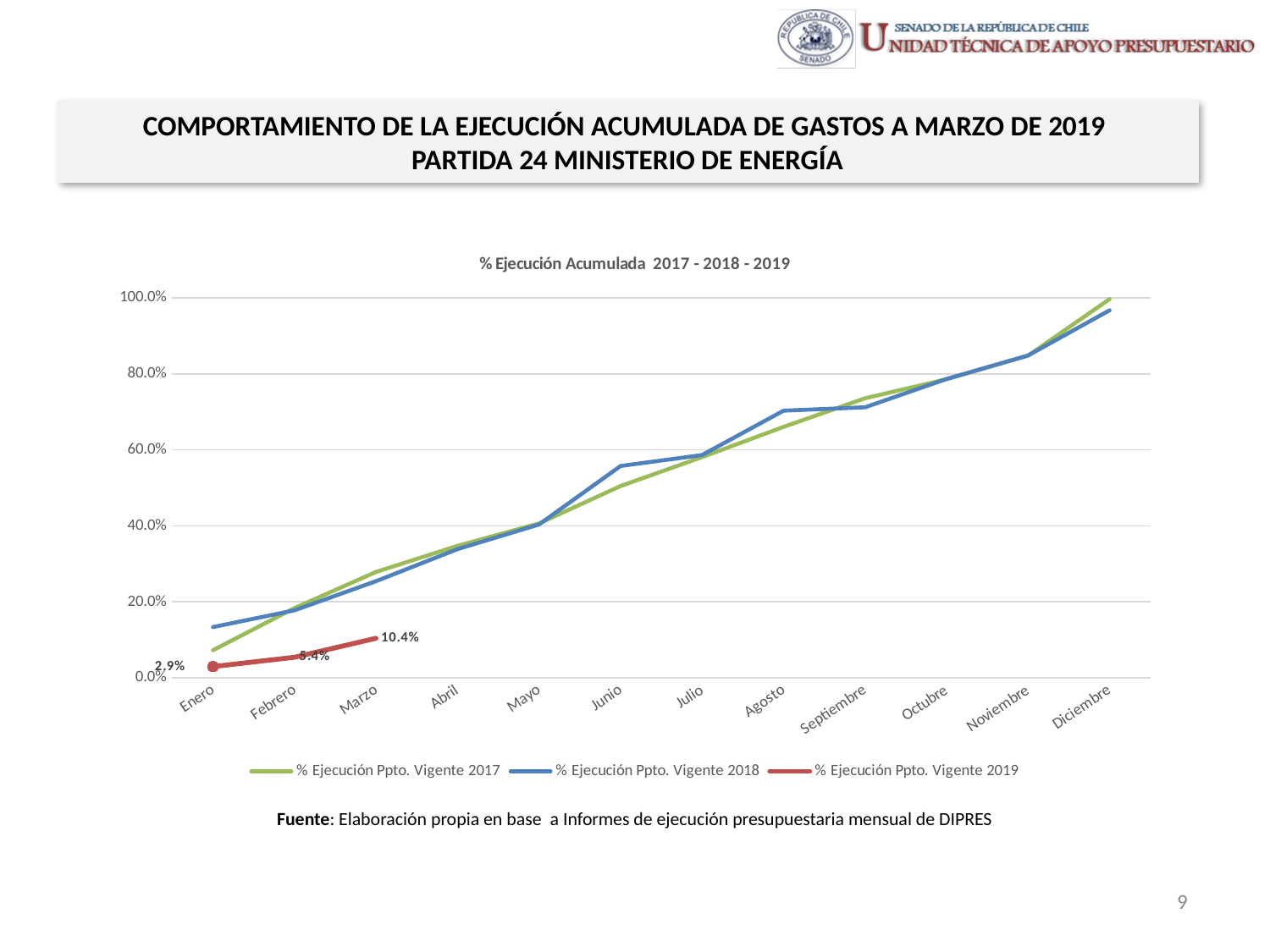
Is the value for % Ejecución Ppto. Vigente 2018 in Junio greater or less than 40%? greater Do the values for % Ejecución Ppto. Vigente 2018 rise or fall from Enero to Diciembre? rise Which month has the highest value for % Ejecución Ppto. Vigente 2019? Marzo How many series does the chart legend list? 3 How many months are shown along the x axis of the chart? 12 What kind of chart is shown on the slide? line chart What is the difference between the 2019 values for Marzo and Enero? 7.5% What is the title of the chart? % Ejecución Acumulada 2017 - 2018 - 2019 Which is larger in Enero: the value for 2018 or the value for 2019? 2018 What is the value of % Ejecución Ppto. Vigente 2019 for Marzo? 10.4% What is the value of % Ejecución Ppto. Vigente 2019 for Febrero? 5.4% What is the value of % Ejecución Ppto. Vigente 2019 for Enero? 2.9%